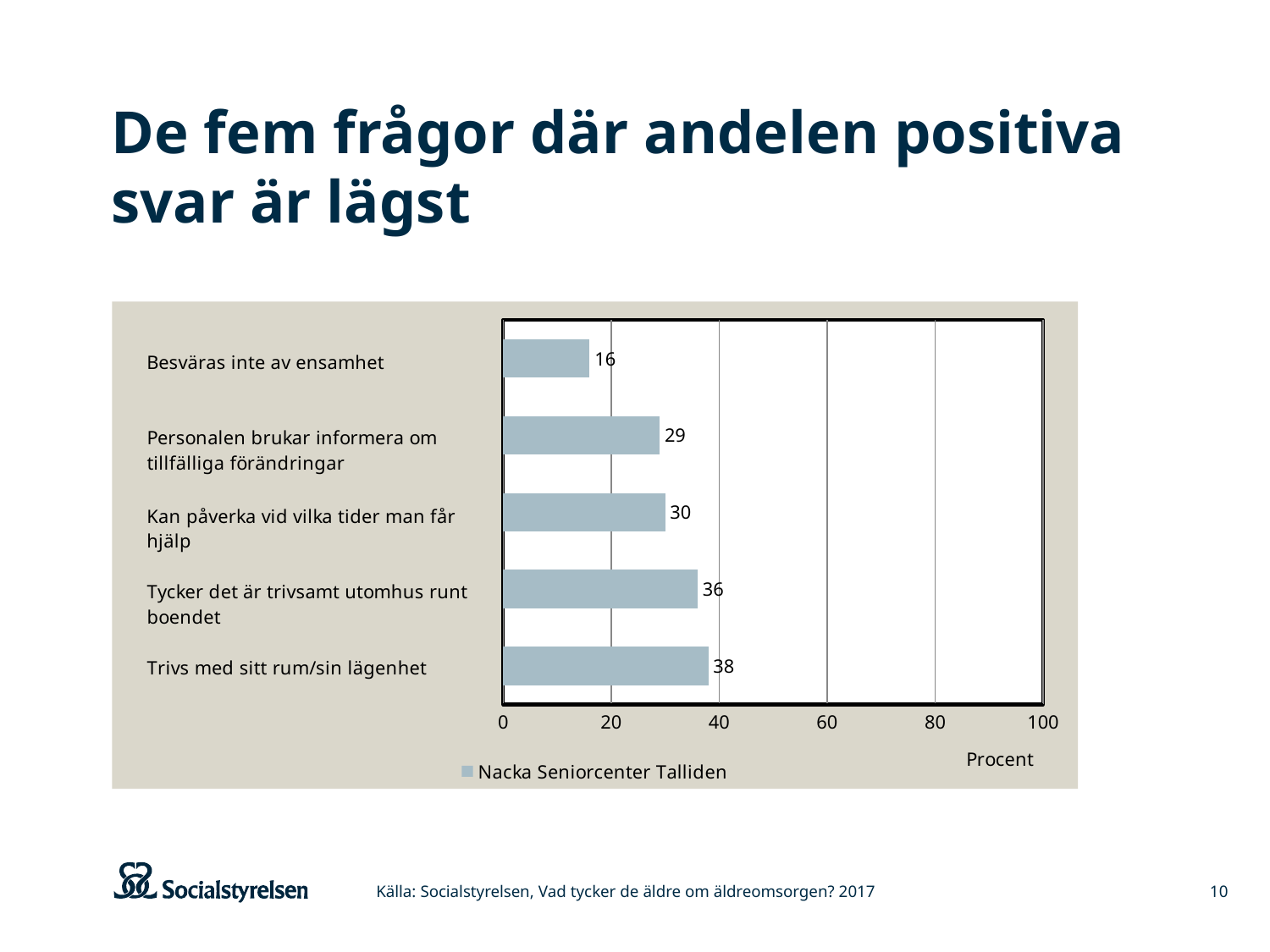
What is the value for "Kan påverka vid vilka tider man får hjälp"? 30 What is the difference between the values for "Trivs med sitt rum/sin lägenhet" and "Besväras inte av ensamhet"? 22 How many series does the legend list? 1 What series name is shown in the legend? Nacka Seniorcenter Talliden What is the value for "Trivs med sitt rum/sin lägenhet"? 38 Which category has the lowest value? Besväras inte av ensamhet Is the value for "Tycker det är trivsamt utomhus runt boendet" greater or less than 40? less Which is larger: the value for "Tycker det är trivsamt utomhus runt boendet" or the value for "Personalen brukar informera om tillfälliga förändringar"? Tycker det är trivsamt utomhus runt boendet How many categories are shown in the chart? 5 Which category has the highest value? Trivs med sitt rum/sin lägenhet What is the value for "Besväras inte av ensamhet"? 16 What kind of chart is shown on the slide? bar chart